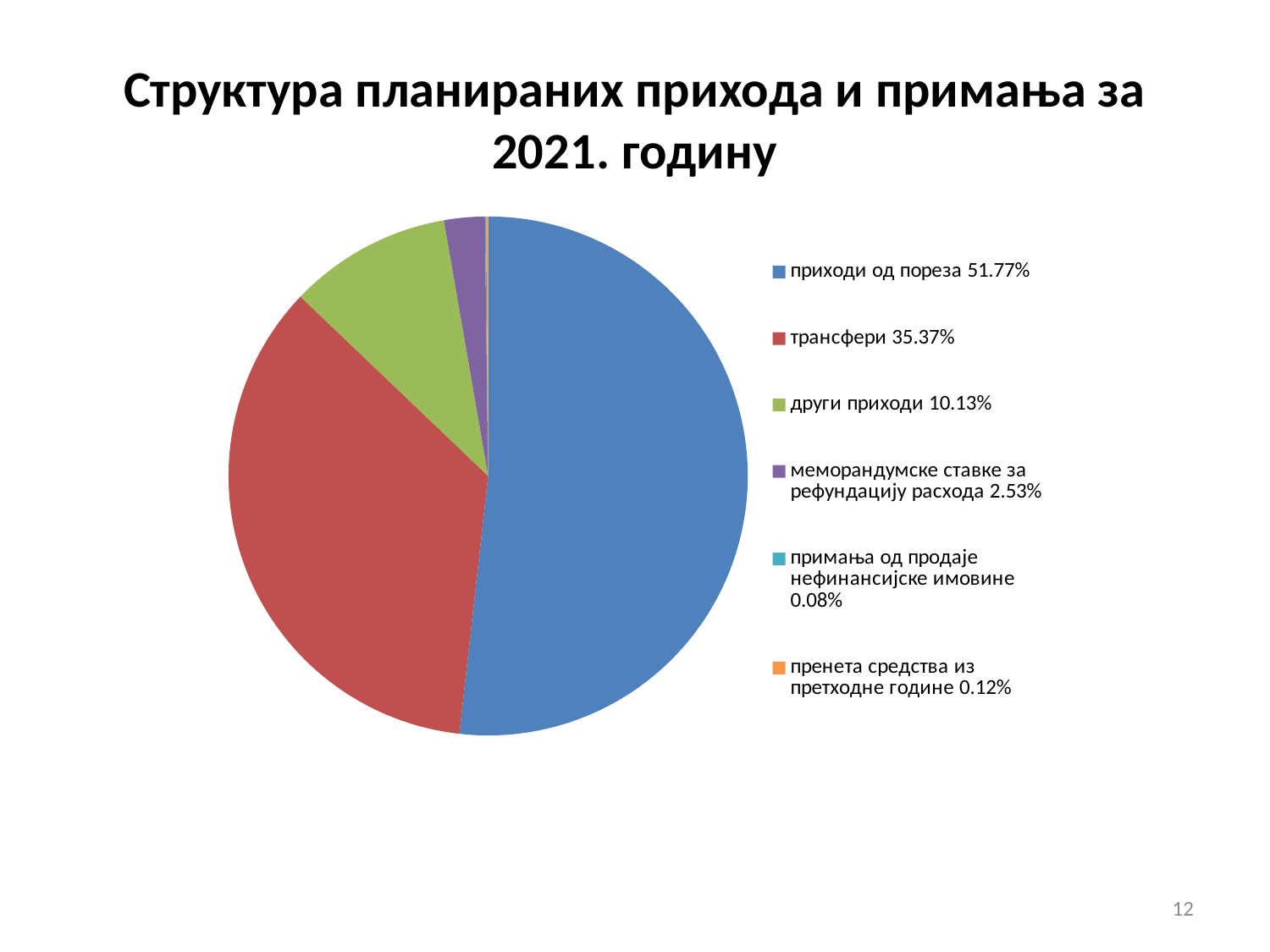
What share of the pie is "приходи од пореза"? 51.77% How many slices does the pie chart have? 6 What share of the pie is "трансфери"? 35.37% What is the difference in percentage points between "приходи од пореза" and "трансфери"? 16.40% What share of the pie is "меморандумске ставке за рефундацију расхода"? 2.53% Which category has the smallest share of the pie? примања од продаје нефинансијске имовине What is the title of the chart on the slide? Структура планираних прихода и примања за 2021. годину Which is larger: the share for "трансфери" or for "други приходи"? трансфери What kind of chart is shown on the slide? pie chart Which category has the largest share of the pie? приходи од пореза